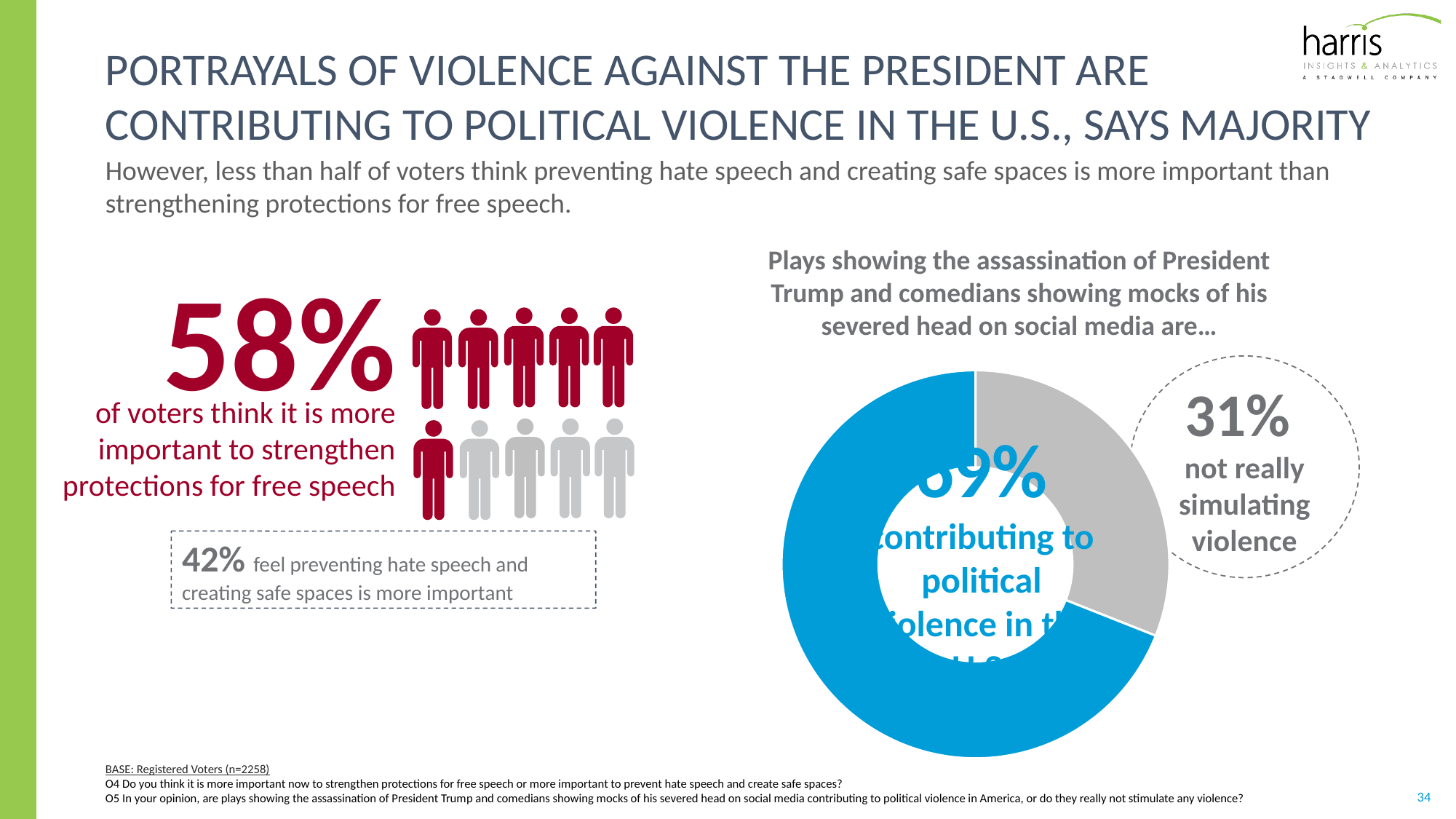
In the donut chart, what percentage say the portrayals are contributing to political violence in the U.S.? 69% How many slices does the donut chart have? 2 What kind of chart is shown on the right side of the slide? donut (pie) chart In the pictogram on the left, what percentage of voters think it is more important to strengthen protections for free speech? 58% In the donut chart, what colour is the slice for 'contributing to political violence in the U.S.'? blue In the donut chart, what colour is the slice for 'not really simulating violence'? grey In the donut chart, which response has the smaller share? not really simulating violence In the donut chart, is the share saying the portrayals are contributing to political violence greater or less than 50%? greater In the pictogram on the left, how many person icons are shown in total? 10 In the donut chart, what is the difference in percentage points between the 'contributing to political violence' share and the 'not really simulating violence' share? 38 percentage points In the donut chart, what percentage say the portrayals are not really simulating violence? 31% In the donut chart, which response has the larger share? contributing to political violence in the U.S.